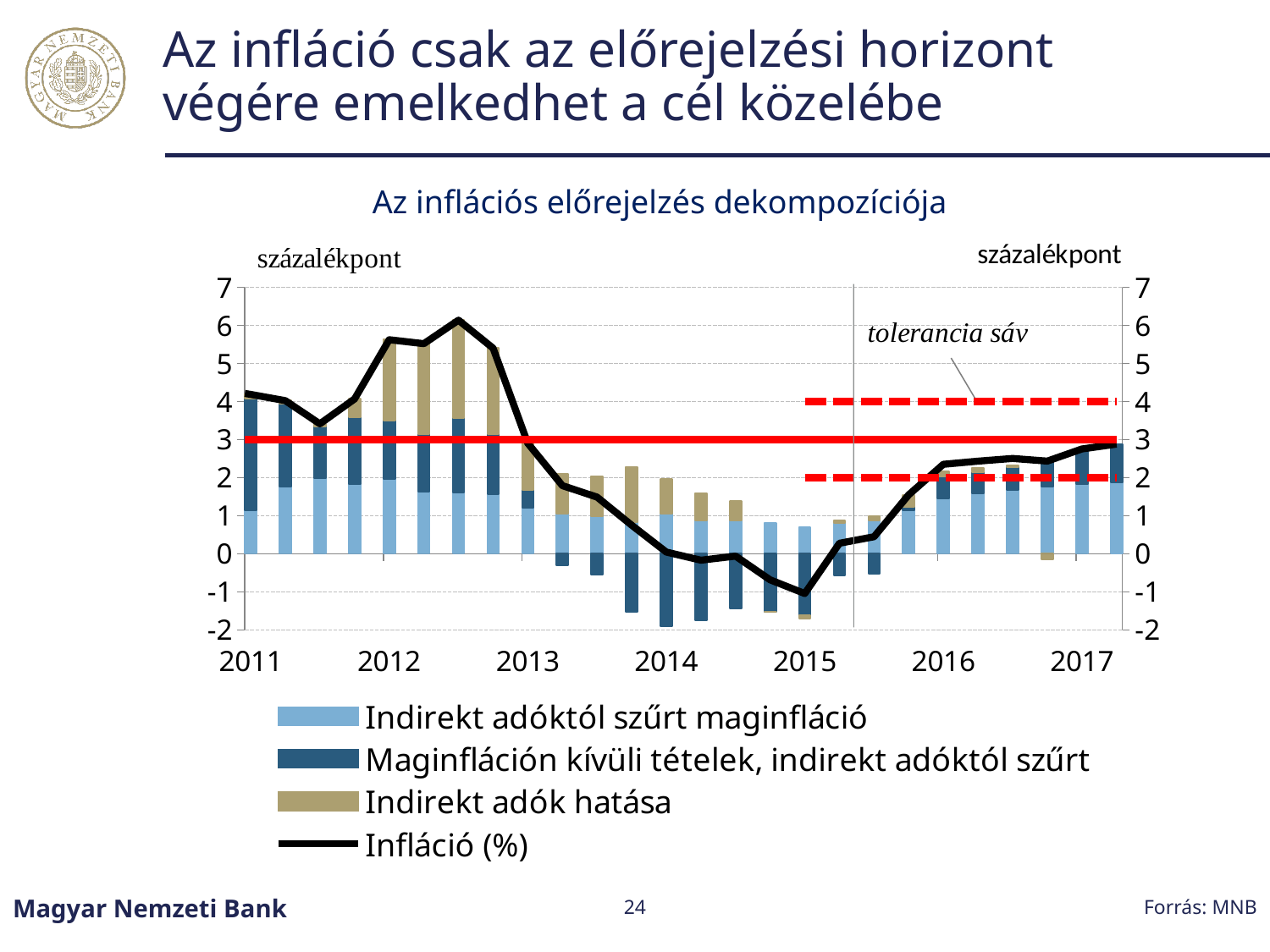
How many series does the legend list? 4 In which year does the Infláció (%) line reach its lowest point? 2015 What kind of chart is shown on the slide? A combined stacked bar and line chart In which year does the Infláció (%) line reach its highest point? 2012 Is the peak value of the Infláció (%) line in 2012 greater or less than 5? greater Does the Infláció (%) line rise or fall between mid-2012 and the start of 2015? Fall Is the value of the Infláció (%) line at the start of 2015 greater or less than 0? less Which legend entry is drawn as a black line rather than bars? Infláció (%) Is the value of the Infláció (%) line at the end of 2017 greater or less than 2? greater How many year labels are shown on the x axis? 7 What is the title of the chart? Az inflációs előrejelzés dekompozíciója Which is larger: the Infláció (%) value at its 2012 peak or its value at the start of 2015? The 2012 peak